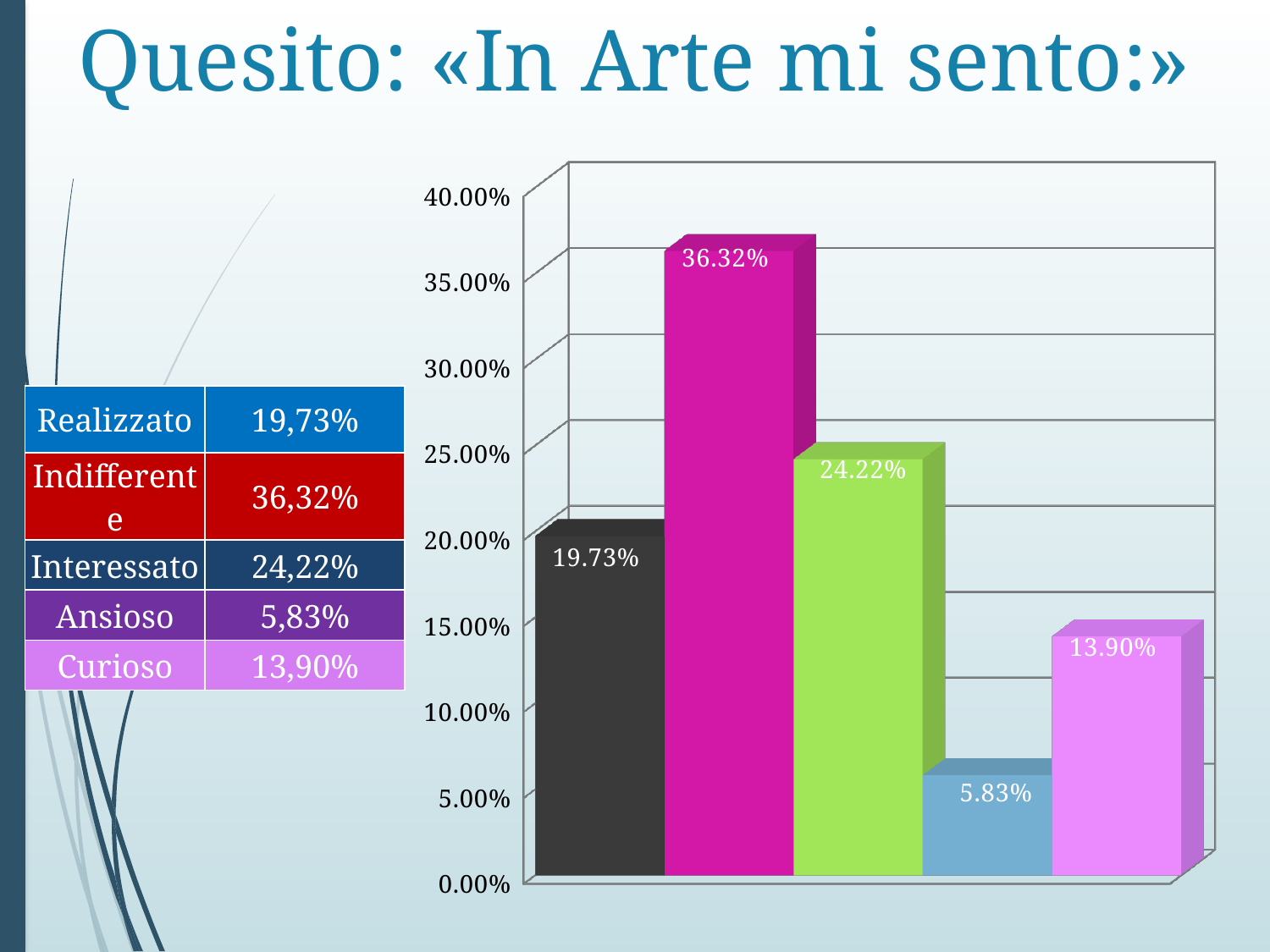
According to the table, what percentage corresponds to 'Interessato'? 24,22% What is the difference between the second bar (36.32%) and the third bar (24.22%) in the chart? 12.10% What value is labelled on the last (rightmost) bar of the chart? 13.90% How many bars are plotted in the chart? 5 What is the value shown on the shortest bar in the chart? 5.83% Which is larger in the chart: the first bar (19.73%) or the fifth bar (13.90%)? the first bar (19.73%) What value is labelled on the first (leftmost) bar of the chart? 19.73% What is the value shown on the tallest bar in the chart? 36.32% Is the value of the second bar in the chart greater or less than 35.00%? greater According to the table, what percentage corresponds to 'Ansioso'? 5,83% What type of chart is shown on the slide? bar chart What value is labelled on the third bar of the chart? 24.22%